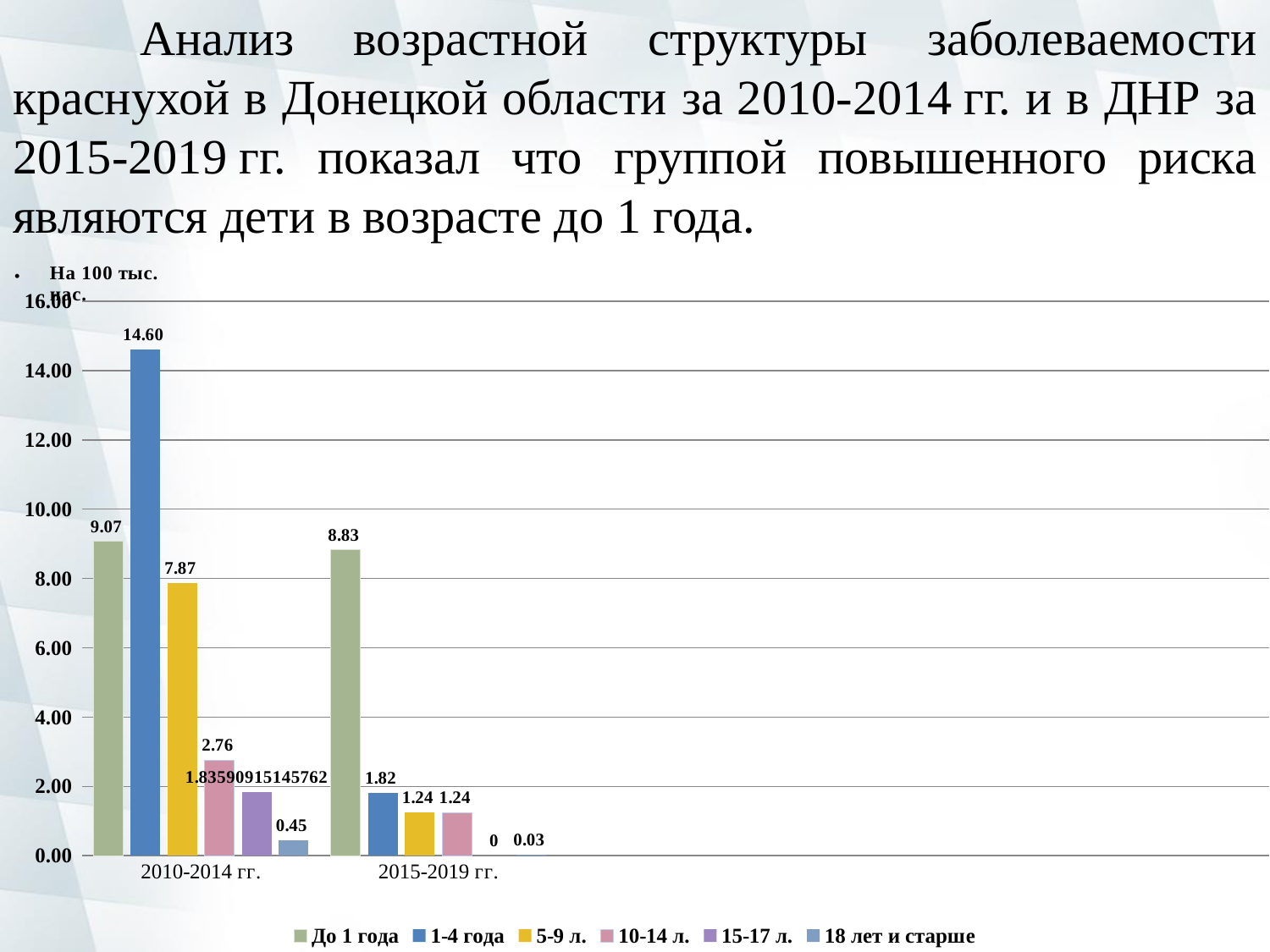
What is the difference between the До 1 года values for 2010-2014 гг. and 2015-2019 гг.? 0.24 Does the value for the 1-4 года series rise or fall from 2010-2014 гг. to 2015-2019 гг.? Fall How many time periods are shown on the x axis? 2 What is the difference between the 1-4 года values for 2010-2014 гг. and 2015-2019 гг.? 12.78 Which age group has the highest value in 2010-2014 гг.? 1-4 года Which age group has the lowest value in 2015-2019 гг.? 15-17 л. What is the value for the До 1 года series in 2015-2019 гг.? 8.83 How many series does the legend list? 6 In 2010-2014 гг., which is larger: the value for До 1 года or for 5-9 л.? До 1 года What is the value for the 1-4 года series in 2010-2014 гг.? 14.60 What is the value for the 18 лет и старше series in 2015-2019 гг.? 0.03 What kind of chart is shown on the slide? Bar chart